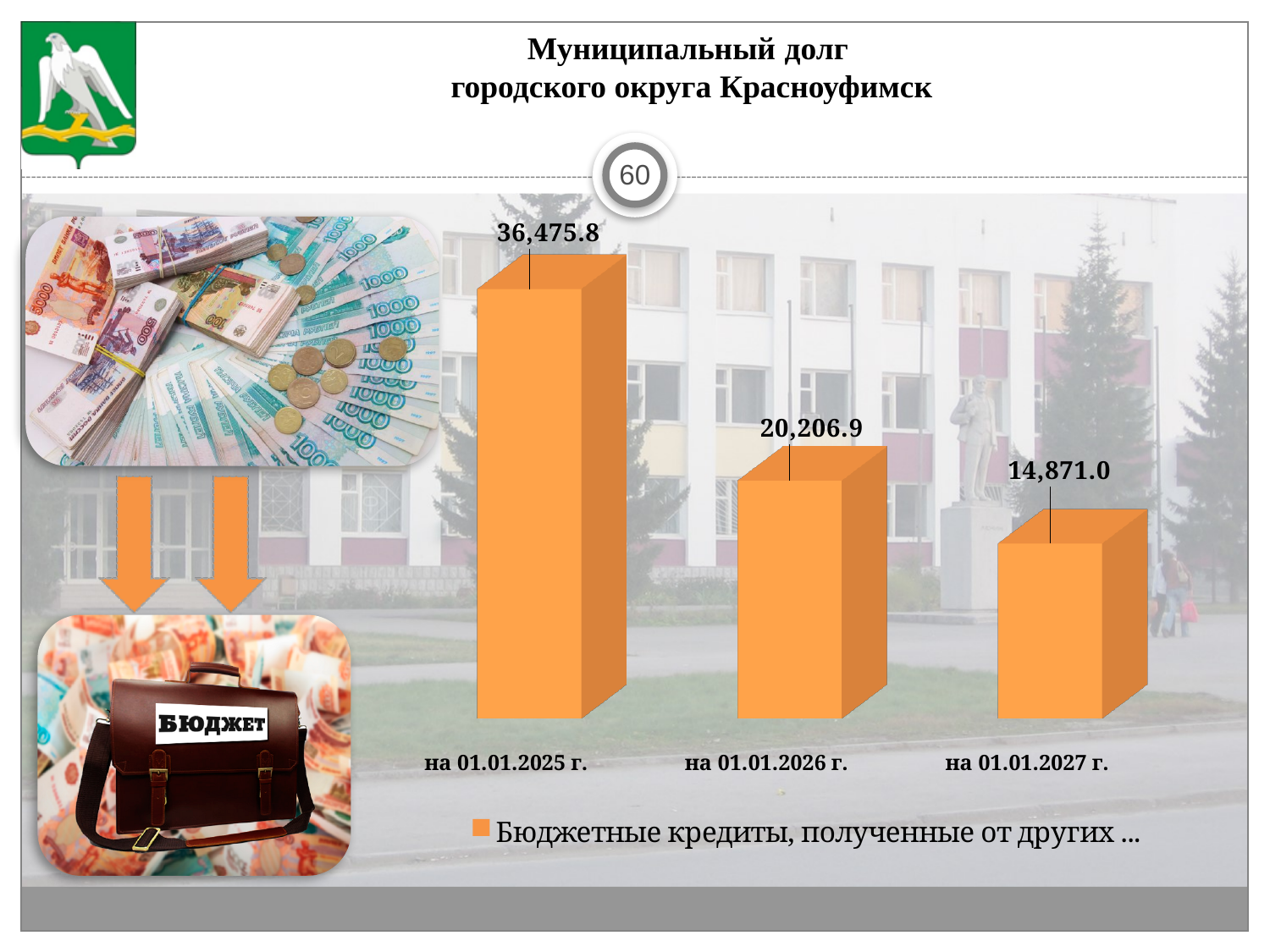
What is the difference between the values for на 01.01.2026 г. and на 01.01.2027 г.? 5,335.9 Which category has the lowest value? на 01.01.2027 г. What is the value for на 01.01.2027 г.? 14,871.0 What is the title of the chart on the slide? Муниципальный долг городского округа Красноуфимск What kind of chart is shown on the slide? bar chart What is the difference between the values for на 01.01.2025 г. and на 01.01.2026 г.? 16,268.9 What is the value for на 01.01.2026 г.? 20,206.9 What is the value for на 01.01.2025 г.? 36,475.8 Which category has the highest value? на 01.01.2025 г. Which is larger, the value for на 01.01.2026 г. or the value for на 01.01.2027 г.? на 01.01.2026 г. How many categories are shown on the chart? 3 Do the values rise or fall from left to right along the x axis? fall